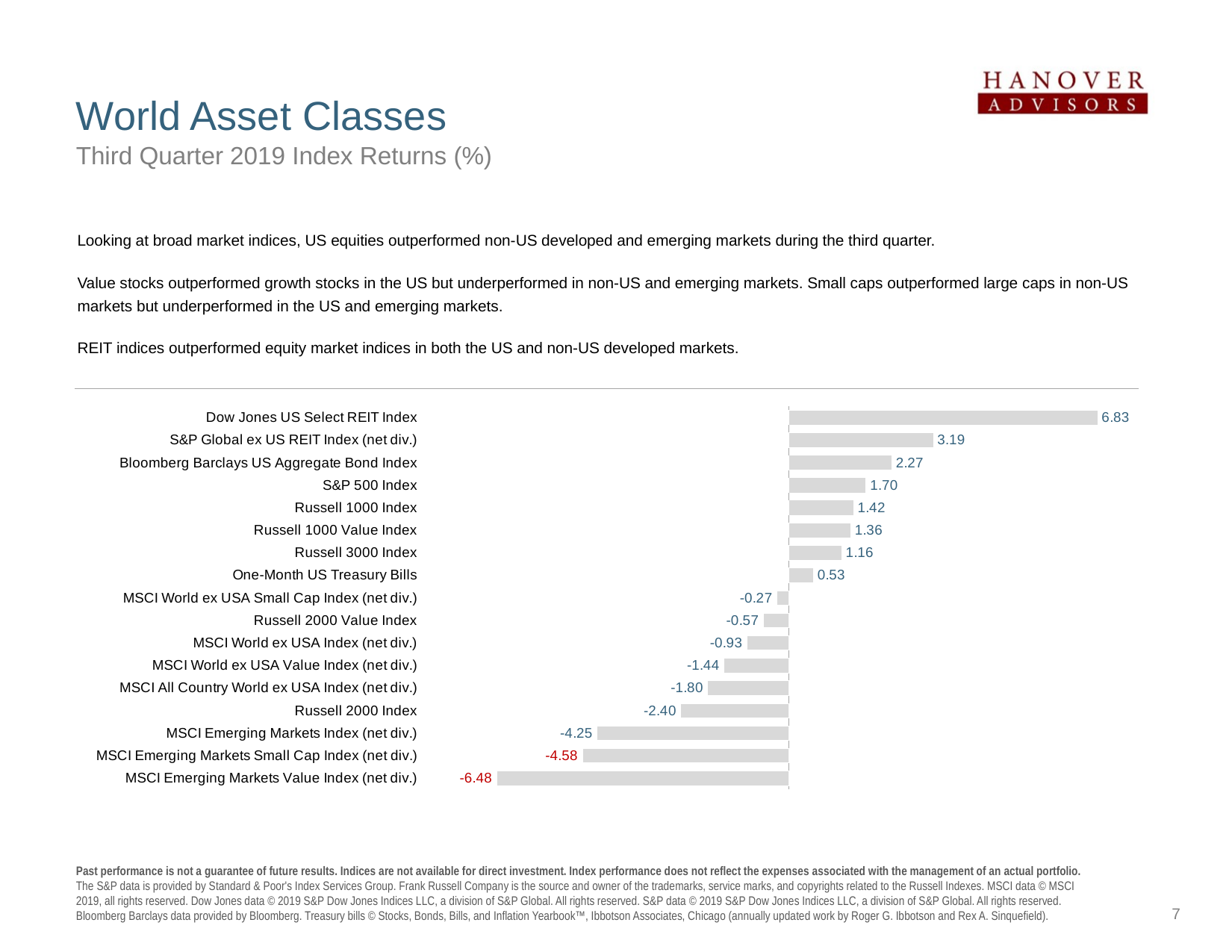
What is the third quarter 2019 return for the Dow Jones US Select REIT Index? 6.83 What is the difference between the Dow Jones US Select REIT Index return and the S&P Global ex US REIT Index (net div.) return? 3.64 Which index has the lowest return on the chart? MSCI Emerging Markets Value Index (net div.) How many indices are plotted on the chart? 17 Which has the higher return, the Russell 2000 Value Index or the Russell 2000 Index? Russell 2000 Value Index Which has the higher return, the Russell 1000 Value Index or the Russell 3000 Index? Russell 1000 Value Index What is the value shown for the MSCI Emerging Markets Small Cap Index (net div.)? -4.58 Which index has the highest return on the chart? Dow Jones US Select REIT Index What type of chart is shown on the slide? Bar chart What is the difference between the S&P 500 Index return and the Russell 1000 Index return? 0.28 What is the value shown for One-Month US Treasury Bills? 0.53 What is the value shown for the S&P 500 Index? 1.70